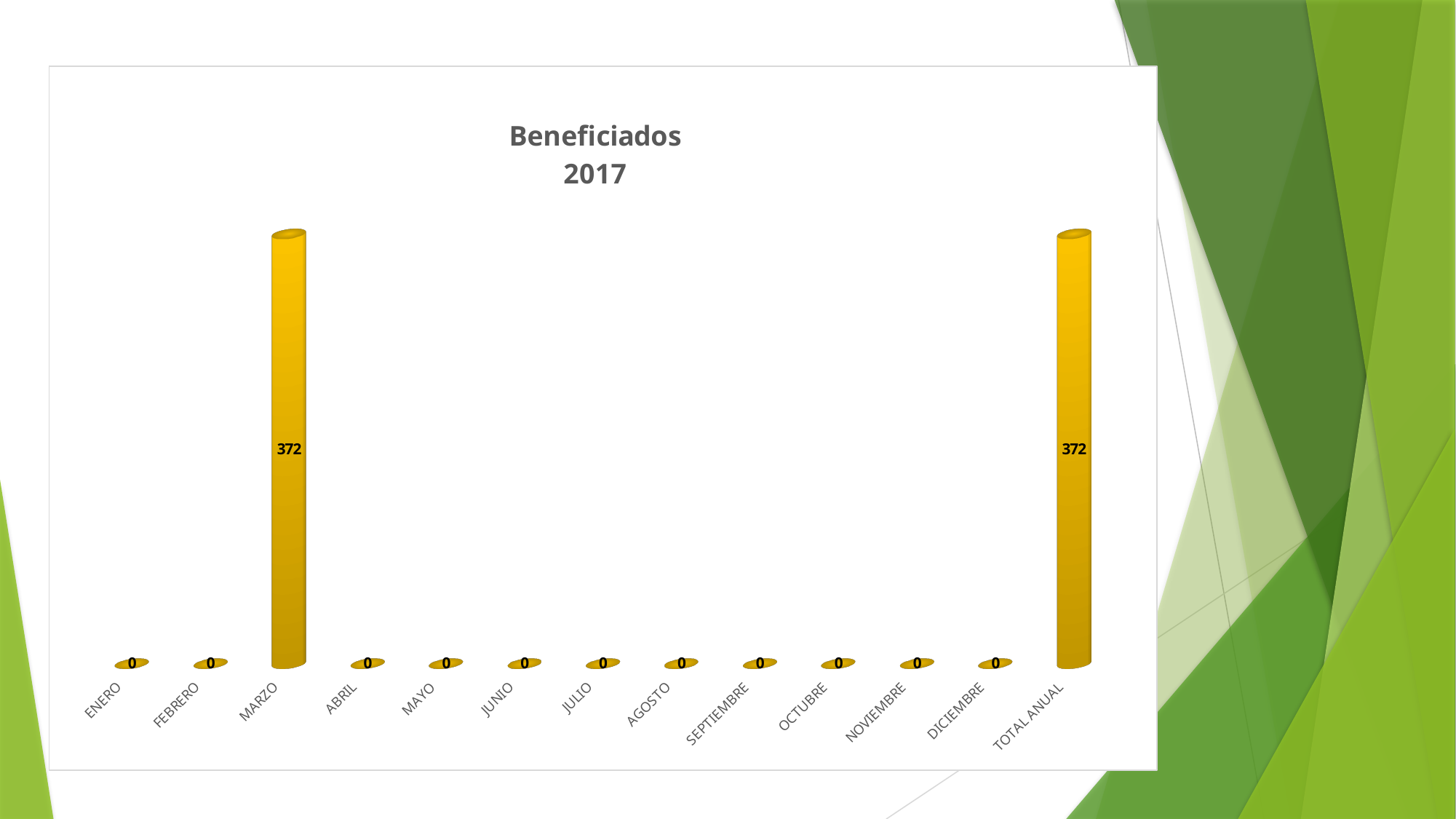
What is the value for MARZO? 372 How many categories are shown on the x axis? 13 What is the value for ENERO? 0 What kind of chart is this? Bar chart How many months have a value of 0? 11 What is the title of the chart? Beneficiados 2017 Which is larger, the value for MARZO or the value for FEBRERO? MARZO Which month has the highest value? MARZO What is the difference between the values for MARZO and ABRIL? 372 What is the value for DICIEMBRE? 0 What is the value for TOTAL ANUAL? 372 What colour are the bars? Yellow/gold